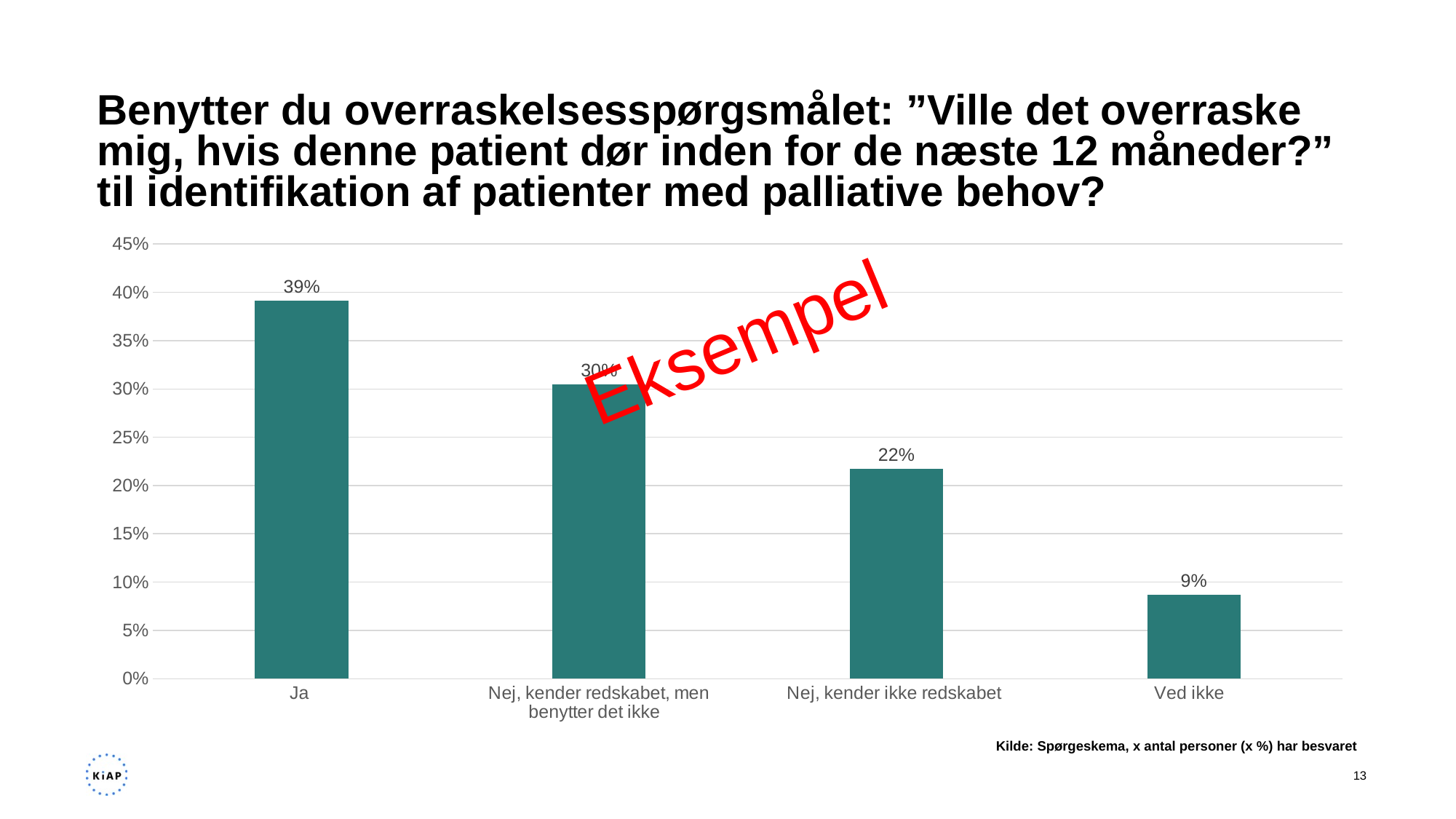
Which category has the highest value? Ja What is the value for "Ved ikke"? 9% Which is larger, the value for "Nej, kender redskabet, men benytter det ikke" or the value for "Nej, kender ikke redskabet"? Nej, kender redskabet, men benytter det ikke What is the value for "Nej, kender ikke redskabet"? 22% What kind of chart is shown on the slide? bar chart What is the value for "Ja"? 39% Do the values rise or fall from left to right along the x axis? fall What is the difference between the values for "Ja" and "Nej, kender ikke redskabet"? 17% Is the value for "Nej, kender redskabet, men benytter det ikke" greater or less than 25%? greater How many categories are shown on the x axis of the chart? 4 What is the difference between the values for "Nej, kender ikke redskabet" and "Ved ikke"? 13% Which category has the lowest value? Ved ikke